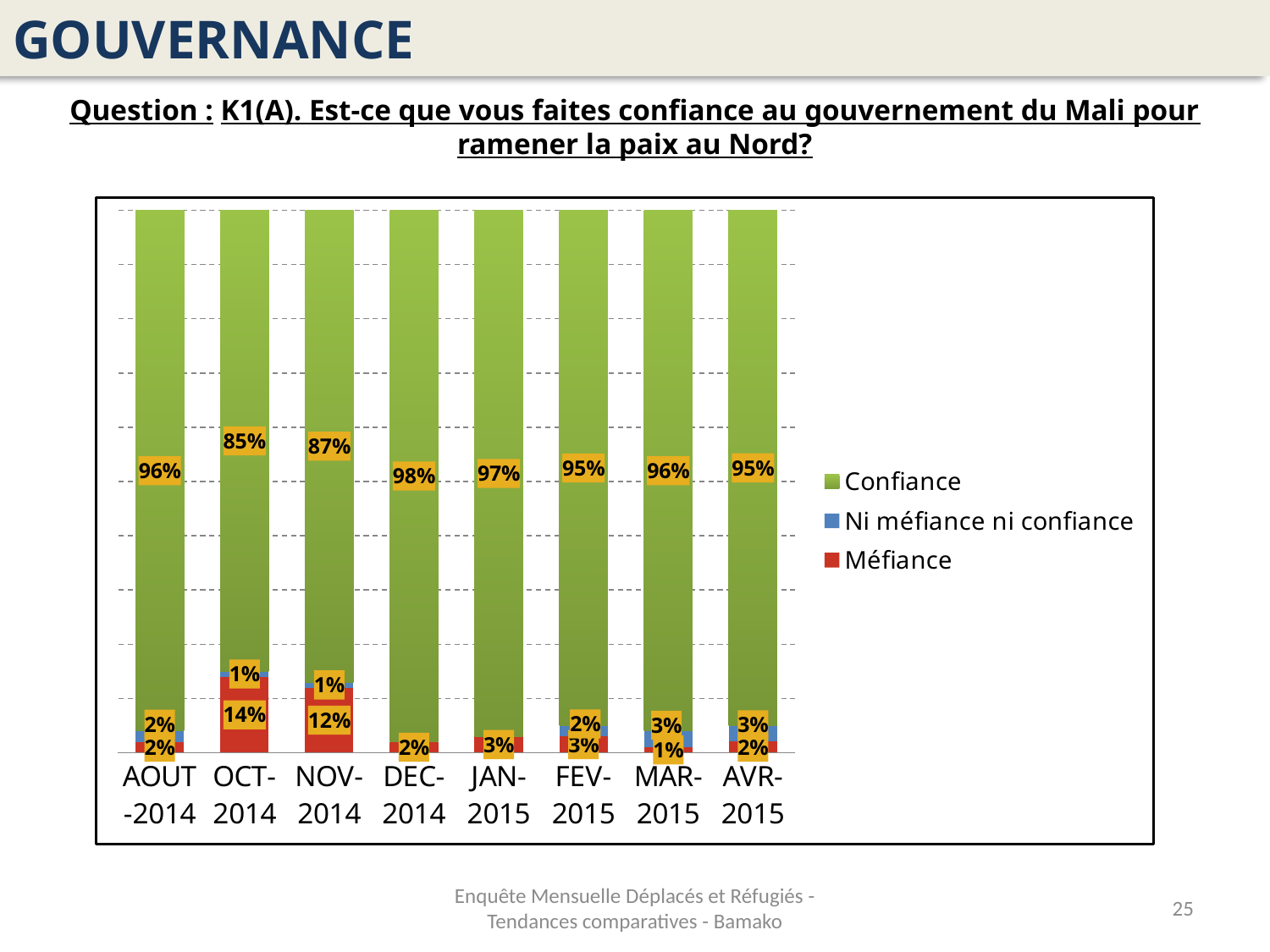
What is the difference between the Méfiance values for OCT-2014 and NOV-2014? 2% Which month has the highest Confiance value? DEC-2014 How many series does the legend list? 3 Which is larger, the Confiance value for JAN-2015 or for FEV-2015? JAN-2015 What is the Méfiance value for NOV-2014? 12% How many months (categories) are shown on the x axis? 8 What is the Confiance value for DEC-2014? 98% What is the Confiance value for OCT-2014? 85% Which series is shown in green in the legend? Confiance What kind of chart is shown on the slide? stacked bar chart What is the Ni méfiance ni confiance value for MAR-2015? 3% Which month has the lowest Confiance value? OCT-2014